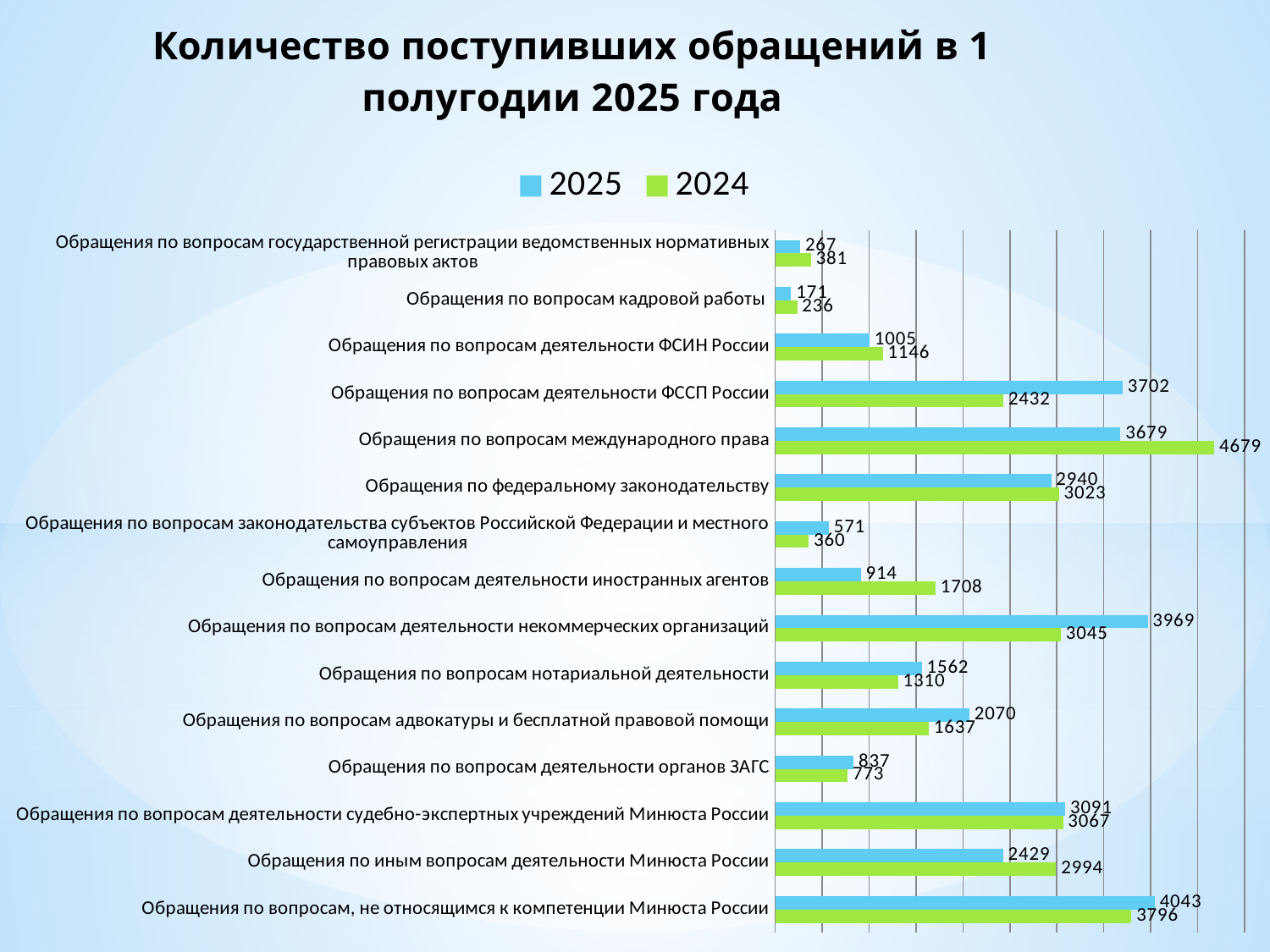
What is the difference between the 2025 and 2024 values for «Обращения по вопросам адвокатуры и бесплатной правовой помощи»? 433 What is the 2025 value for «Обращения по вопросам деятельности иностранных агентов»? 914 How many series does the legend list? 2 Which colour represents the 2024 series in the legend? green What is the difference between the 2024 and 2025 values for «Обращения по вопросам деятельности иностранных агентов»? 794 What is the 2025 value for «Обращения по вопросам деятельности ФССП России»? 3702 What is the 2024 value for «Обращения по вопросам международного права»? 4679 What type of chart is shown on the slide? bar chart For «Обращения по вопросам деятельности некоммерческих организаций», which year has the larger value, 2025 or 2024? 2025 Which category has the highest 2025 value? Обращения по вопросам, не относящимся к компетенции Минюста России Which category has the lowest 2024 value? Обращения по вопросам кадровой работы How many categories are shown in the chart? 15